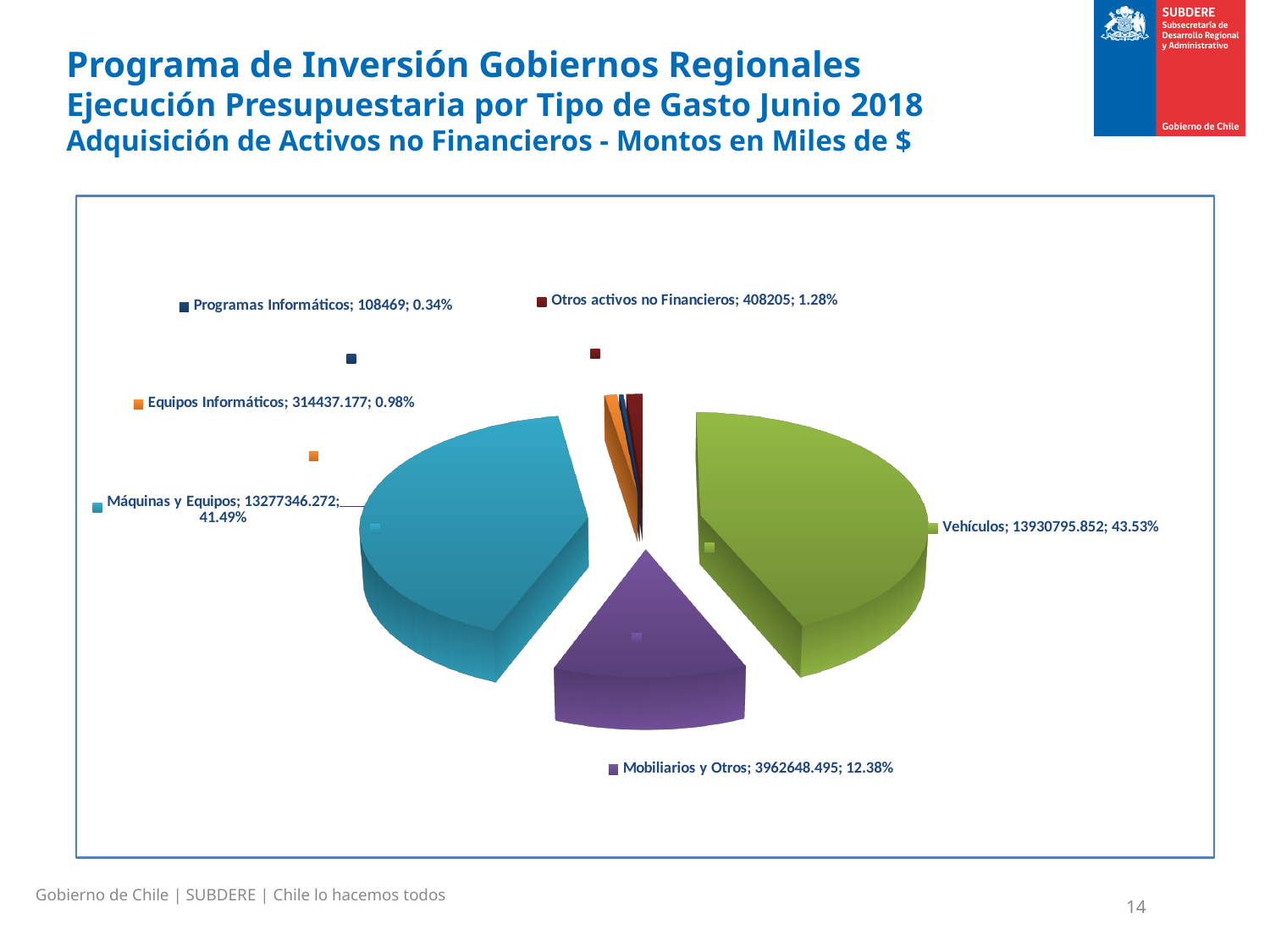
How many slices does the pie chart have? 6 What percentage share does Máquinas y Equipos have? 41.49% Which category has the largest slice of the pie? Vehículos What is the difference in percentage share between Vehículos and Máquinas y Equipos? 2.04% What is the difference between the values for Otros activos no Financieros and Programas Informáticos? 299736 Which category has the smallest slice of the pie? Programas Informáticos What is the value shown for Programas Informáticos? 108469 What is the value shown for Vehículos? 13930795.852 What kind of chart is shown on the slide? Pie chart What is the value shown for Equipos Informáticos? 314437.177 Which is larger, the value for Máquinas y Equipos or the value for Mobiliarios y Otros? Máquinas y Equipos What percentage share does Mobiliarios y Otros have? 12.38%